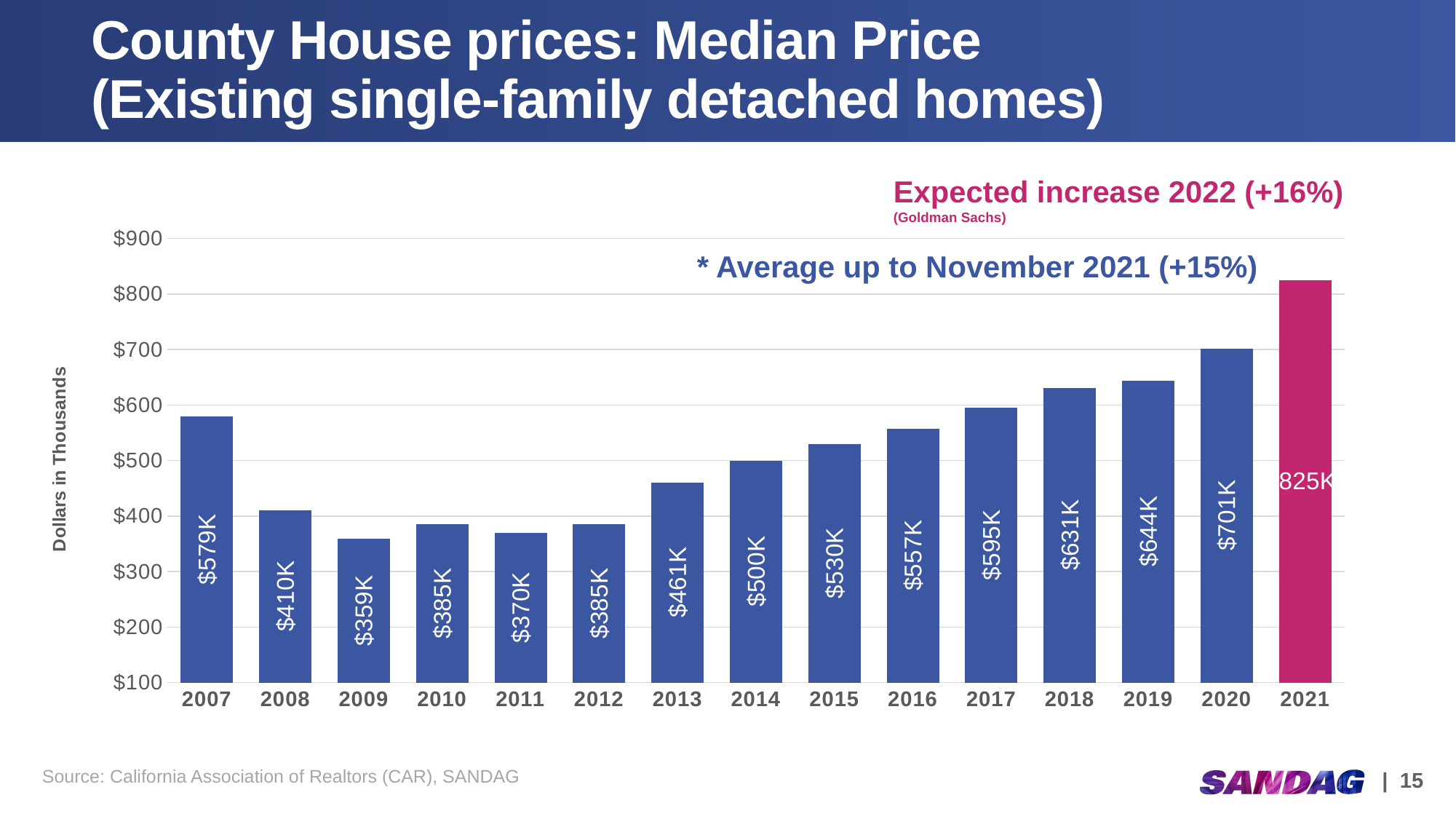
What is the difference between the median price in 2007 and in 2008? $169K Which year has the lowest median price? 2009 What is the median price shown for 2014? $500K What is the median price shown for 2020? $701K Which year has a higher median price, 2013 or 2016? 2016 Is the median price for 2018 greater or less than $600? greater Which year has the highest median price? 2021 How many years are shown on the x axis? 15 What is the difference between the median price in 2020 and in 2019? $57K What kind of chart is shown on the slide? bar chart What is the median price shown for 2007? $579K What is the label on the vertical axis? Dollars in Thousands